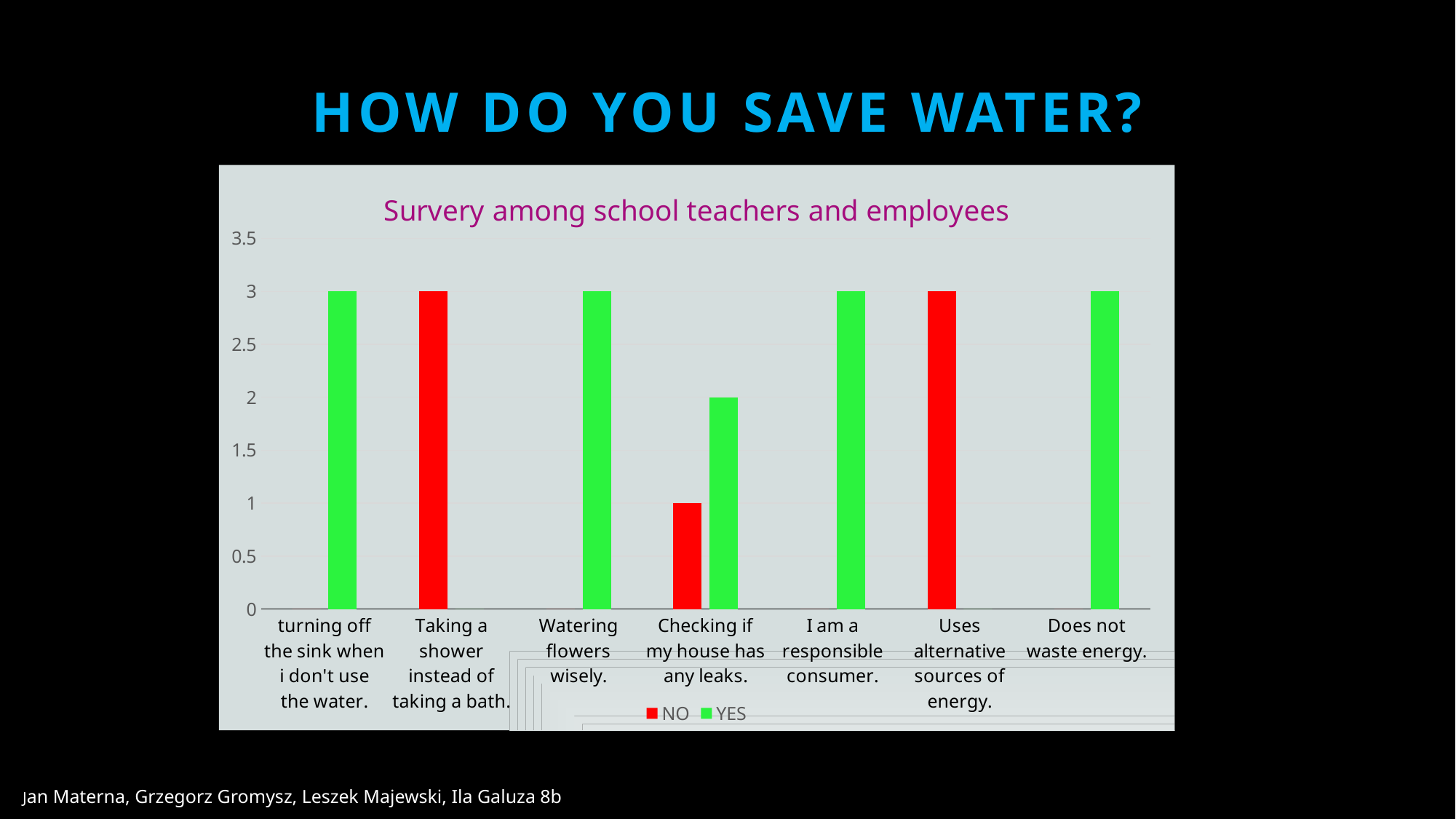
How many categories are shown on the x axis? 7 What is the YES value for 'Watering flowers wisely.'? 3 What is the YES value for 'Checking if my house has any leaks.'? 2 What is the NO value for 'Taking a shower instead of taking a bath.'? 3 Which colour represents the NO series in the legend? red What type of chart is shown on the slide? bar chart For 'Checking if my house has any leaks.', which is larger, the YES value or the NO value? YES How many series does the legend list? 2 What is the difference between the YES and NO values for 'Checking if my house has any leaks.'? 1 Which category has the lowest YES value among those with a YES bar? Checking if my house has any leaks. What is the title of the chart? Survery among school teachers and employees What is the NO value for 'Checking if my house has any leaks.'? 1